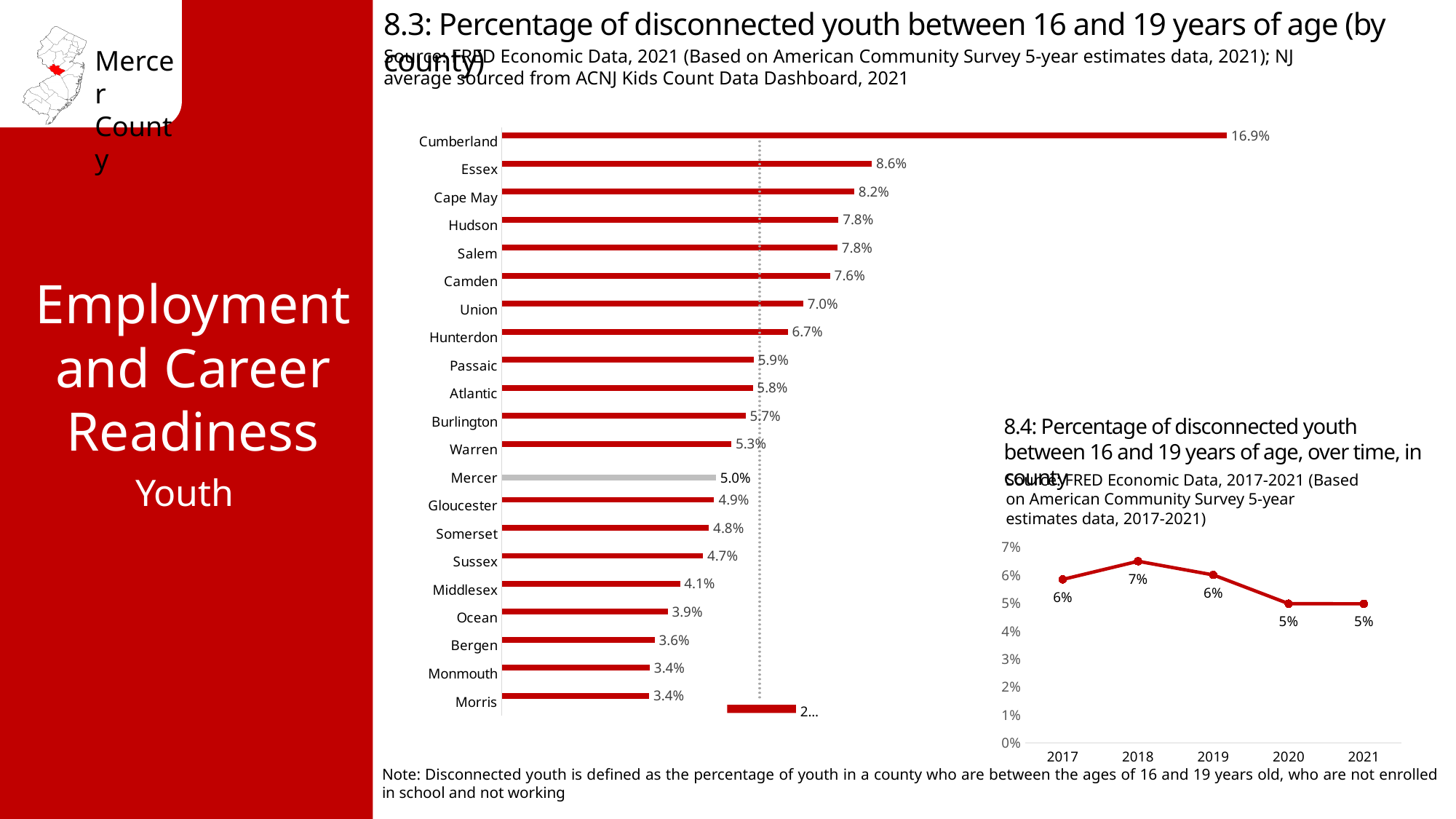
In the chart 8.3 (by county), what is the value for Essex? 8.6% In the chart 8.4 (over time), what is the value for 2018? 7% In the chart 8.3 (by county), which is larger, the value for Hudson or the value for Camden? Hudson In the chart 8.3 (by county), what is the difference between Essex and Mercer? 3.6% In the chart 8.4 (over time), what is the difference between the 2018 value and the 2021 value? 2% What kind of chart is chart 8.4 (over time)? Line chart In the chart 8.3 (by county), what is the percentage of disconnected youth for Mercer? 5.0% In the chart 8.3 (by county), what is the value for Bergen? 3.6% What kind of chart is chart 8.3 (by county)? Bar chart In the chart 8.3 (by county), which county has the highest percentage of disconnected youth? Cumberland In the chart 8.4 (over time), how many years are plotted? 5 In the chart 8.3 (by county), what is the value for Cumberland? 16.9%